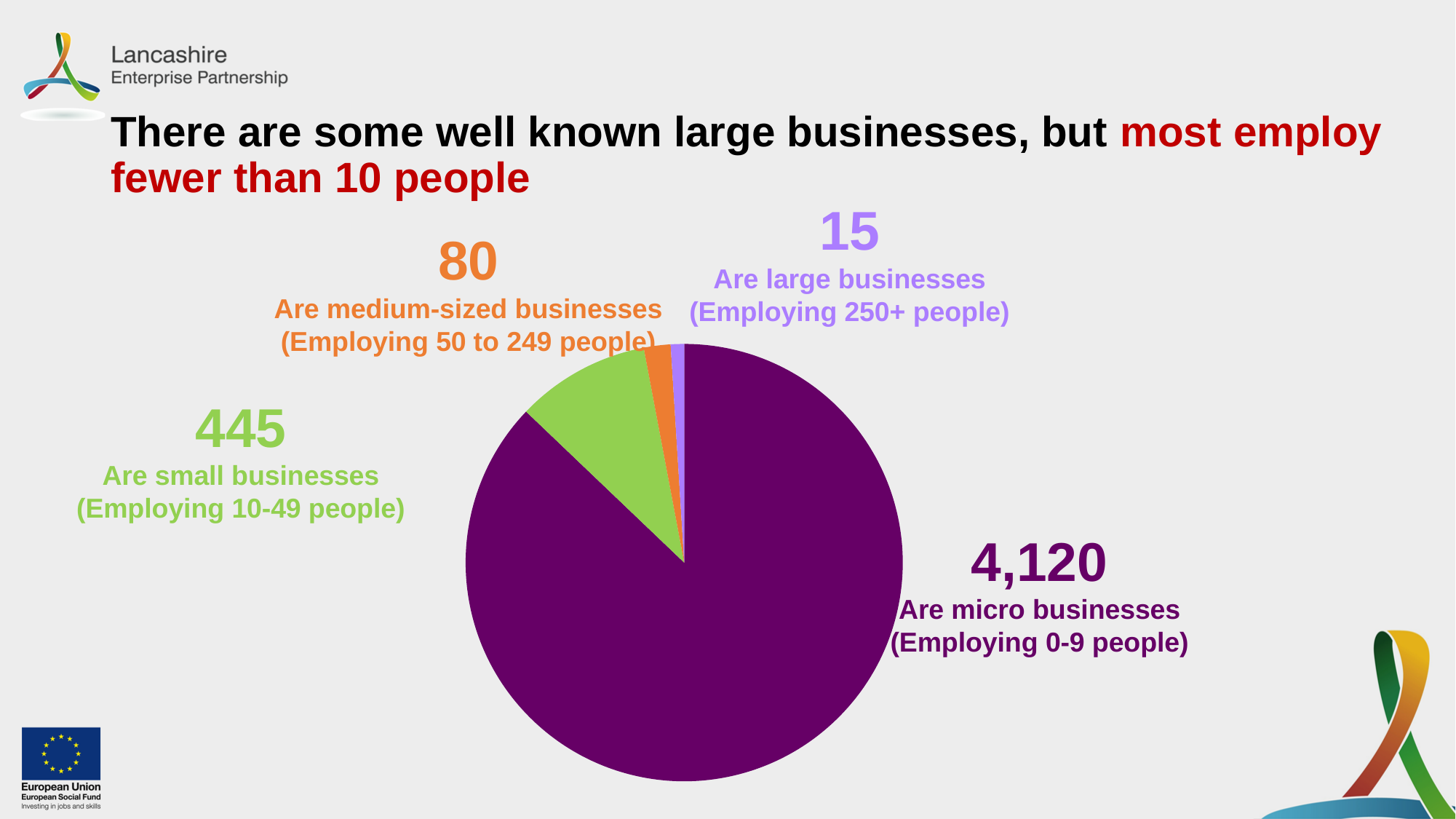
How many medium-sized businesses (employing 50 to 249 people) are shown on the chart? 80 Which business size category has the smallest slice of the pie? Large businesses (Employing 250+ people) What is the total number of businesses across all four slices of the pie? 4,660 What colour is the slice representing small businesses (employing 10-49 people)? green What is the difference between the number of small businesses and the number of medium-sized businesses? 365 How many micro businesses (employing 0-9 people) are shown on the chart? 4,120 How many large businesses (employing 250+ people) are shown on the chart? 15 Which is larger: the number of medium-sized businesses or the number of large businesses? Medium-sized businesses Which business size category has the largest slice of the pie? Micro businesses (Employing 0-9 people) How many small businesses (employing 10-49 people) are shown on the chart? 445 How many categories does the pie chart have? 4 What kind of chart is shown on the slide? pie chart